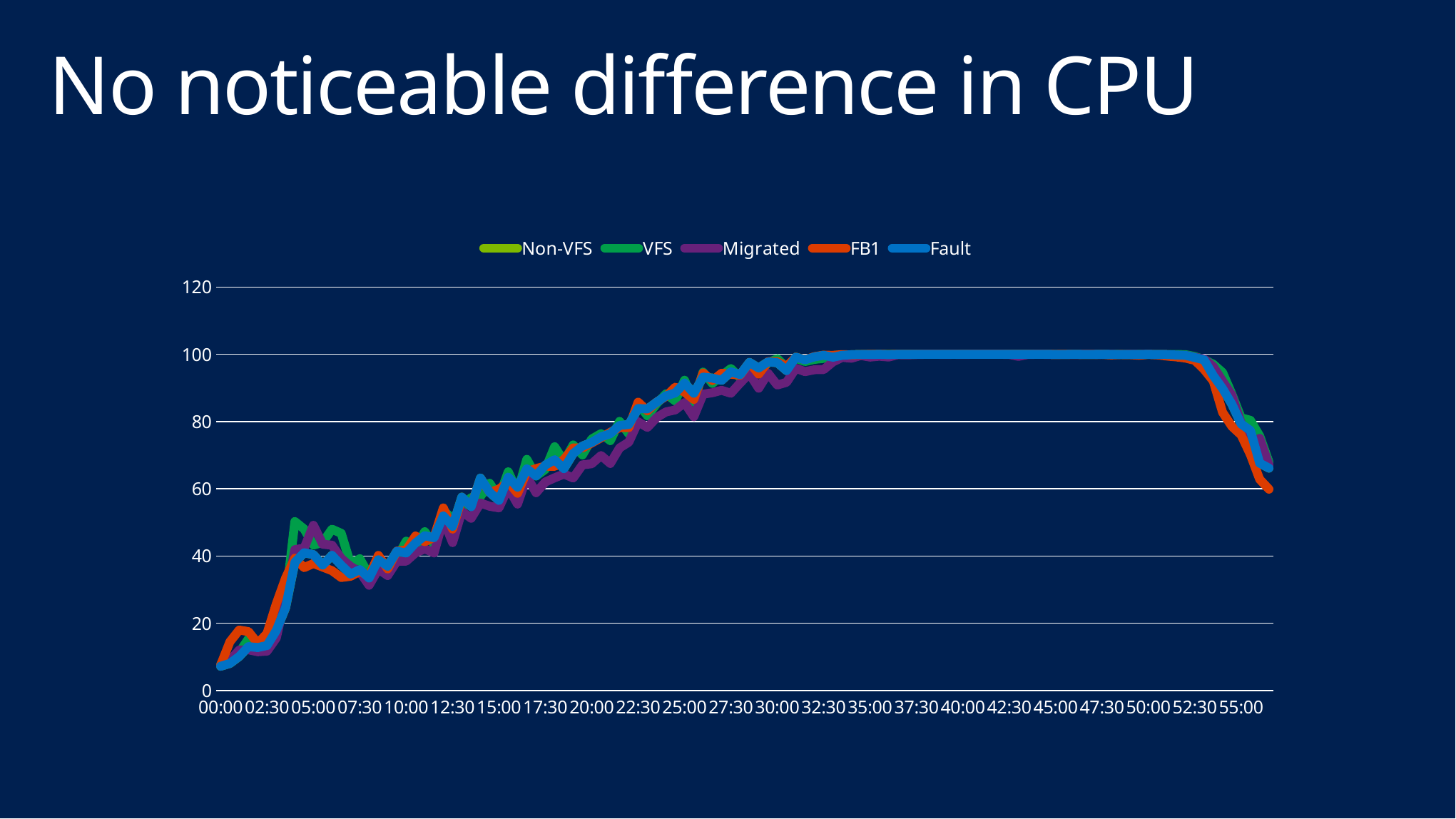
Is the value of the FB1 series at 40:00 greater or less than 80? greater How many series does the legend list? 5 What kind of chart is shown on the slide? line chart Is the value of the Migrated series at 10:00 greater or less than 60? less Do the series values generally rise or fall between 00:00 and 32:30? rise How many time labels are shown along the x axis? 23 Which series is drawn in blue in the chart? Fault Is the value of the VFS series at 25:00 greater or less than 80? greater What is the highest value labelled on the y axis? 120 What is the title of the slide containing the chart? No noticeable difference in CPU